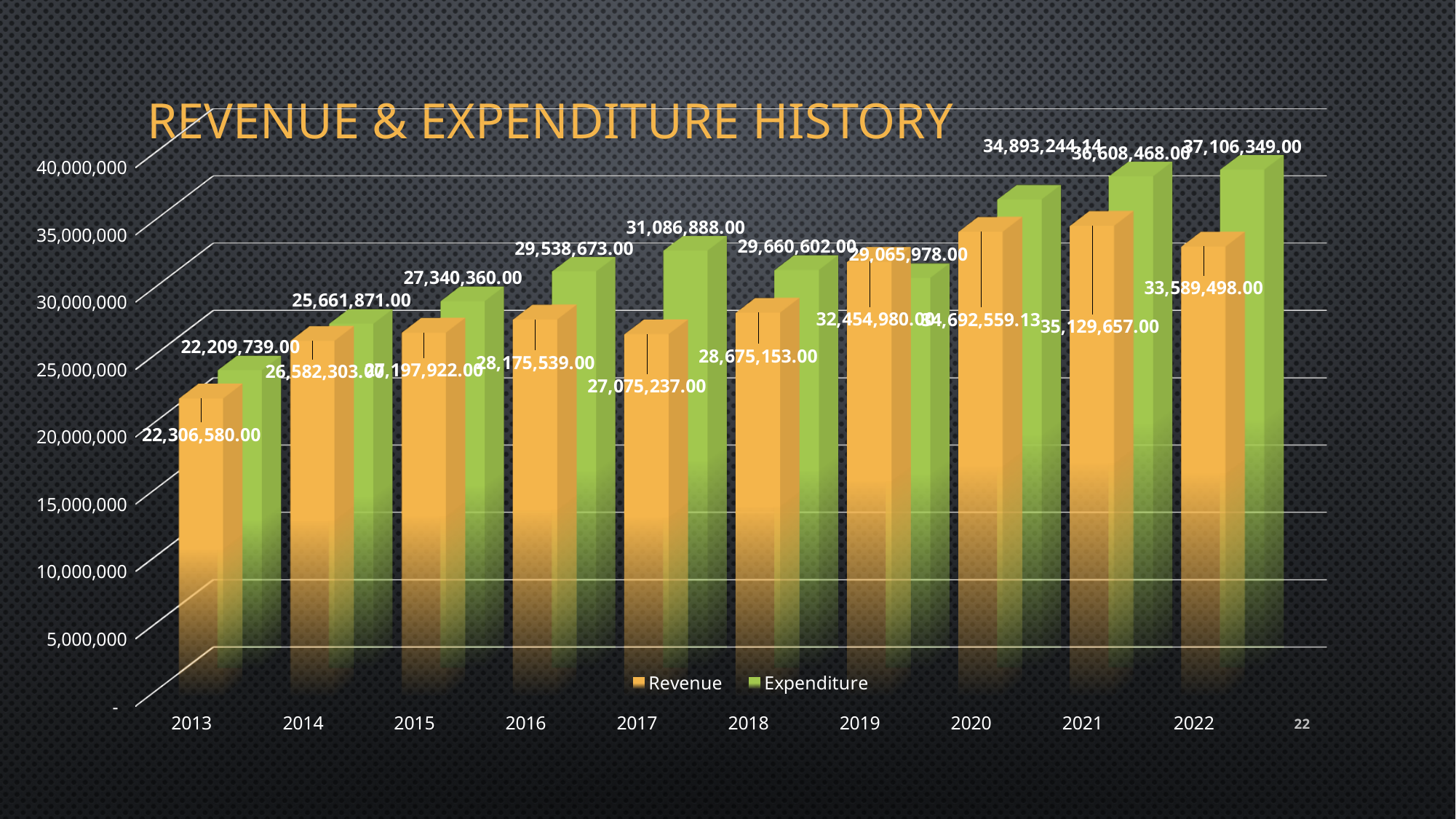
What is the Revenue value for 2020? 34,692,559.13 In which year is Expenditure the highest? 2022 In which year is Revenue the lowest? 2013 What is the Expenditure value for 2017? 31,086,888.00 Does Expenditure generally rise or fall from 2013 to 2022? Rise In 2022, which is larger, Revenue or Expenditure? Expenditure What kind of chart is this? Bar chart How many years are shown on the x axis? 10 How many series does the legend list? 2 What is the Revenue value for 2013? 22,306,580.00 What is the difference between Expenditure and Revenue in 2017? 4,011,651.00 What is the Expenditure value for 2022? 37,106,349.00